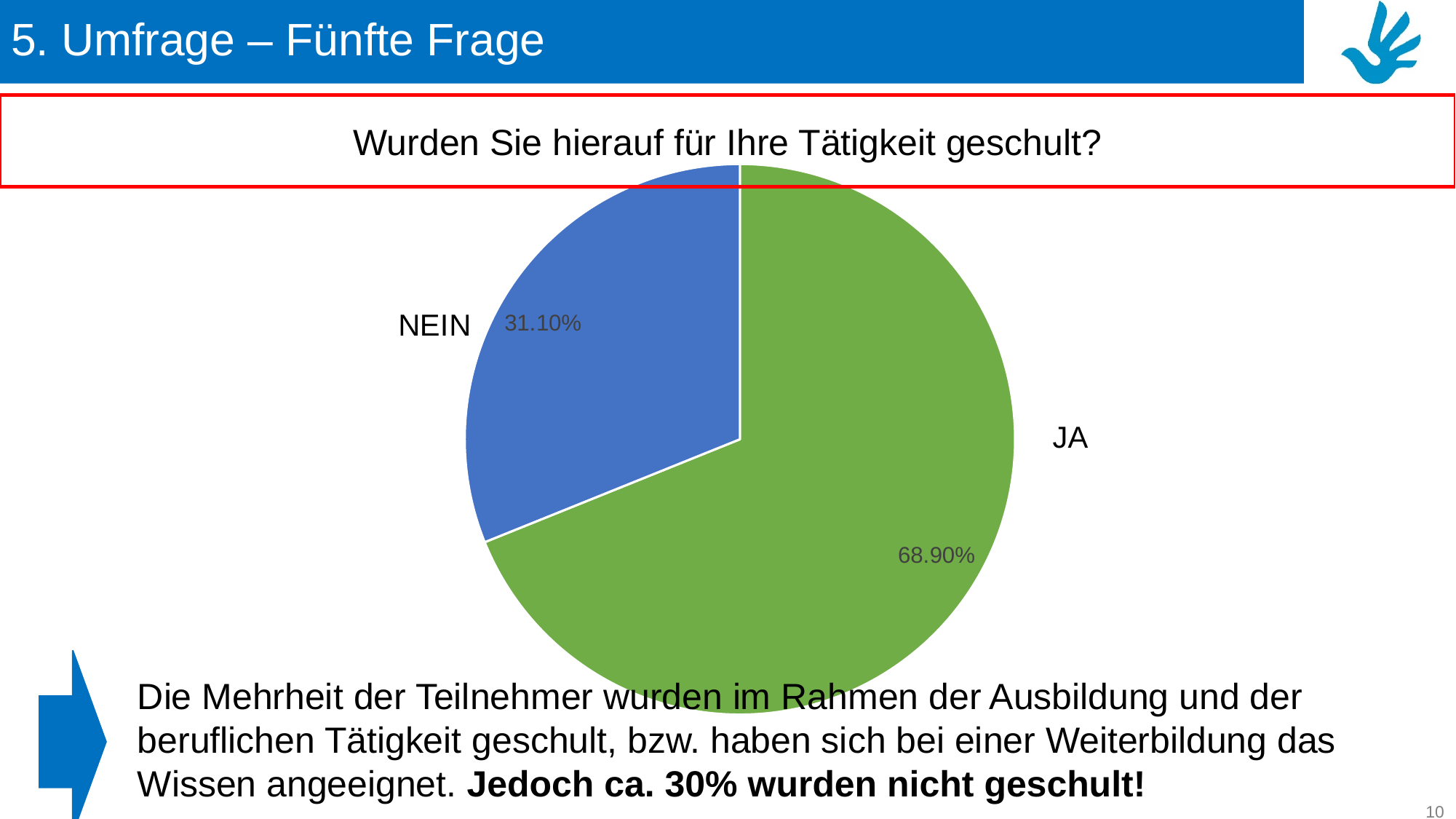
How many slices does the pie chart have? 2 What colour is the JA slice of the pie chart? green What question is the pie chart answering, as shown in the red box above it? Wurden Sie hierauf für Ihre Tätigkeit geschult? Which slice is larger, JA or NEIN? JA Which slice of the pie chart is the largest? JA What share of the pie does the NEIN slice represent? 31.10% What is the difference in percentage points between the JA and NEIN slices? 37.80 What is the total of the two slices shown in the pie chart? 100.00% What percentage of the pie chart is labelled NEIN? 31.10% What kind of chart is shown on the slide? pie chart What percentage of the pie chart is labelled JA? 68.90% Which slice of the pie chart is the smallest? NEIN